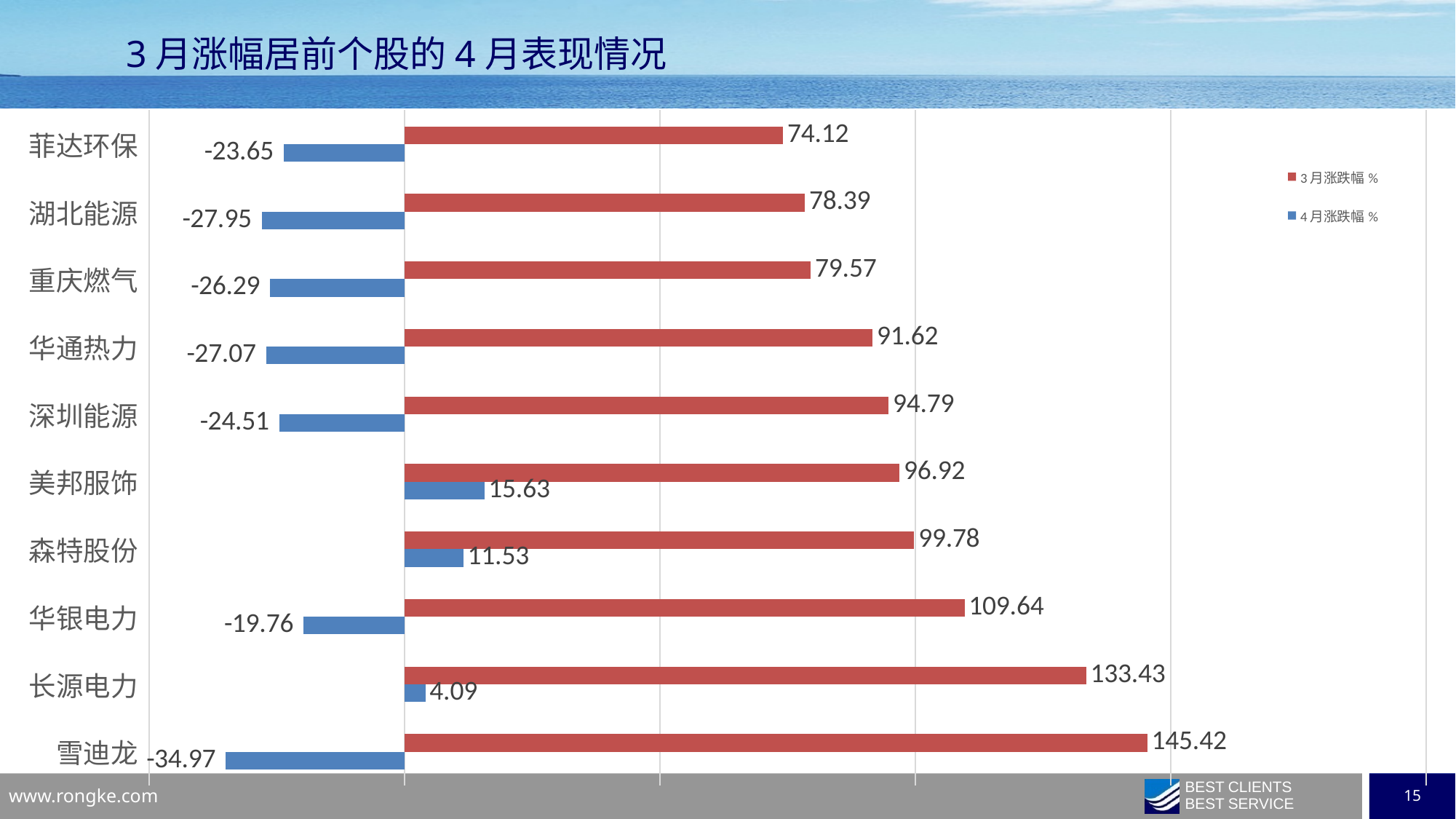
What is the 4月涨跌幅 % value for 美邦服饰? 15.63 What is the 3月涨跌幅 % value for 雪迪龙? 145.42 How many series does the legend list? 2 Which stock has the lowest 3月涨跌幅 % value? 菲达环保 Which stock has the highest 3月涨跌幅 % value? 雪迪龙 What kind of chart is shown on the slide? bar chart How many stocks are shown in the chart? 10 Which stock has the lowest 4月涨跌幅 % value? 雪迪龙 What is the difference between the 3月涨跌幅 % values of 长源电力 and 华银电力? 23.79 What is the difference between the 3月涨跌幅 % and 4月涨跌幅 % values for 雪迪龙? 180.39 What is the 4月涨跌幅 % value for 湖北能源? -27.95 Which is larger, the 4月涨跌幅 % value for 森特股份 or for 长源电力? 森特股份